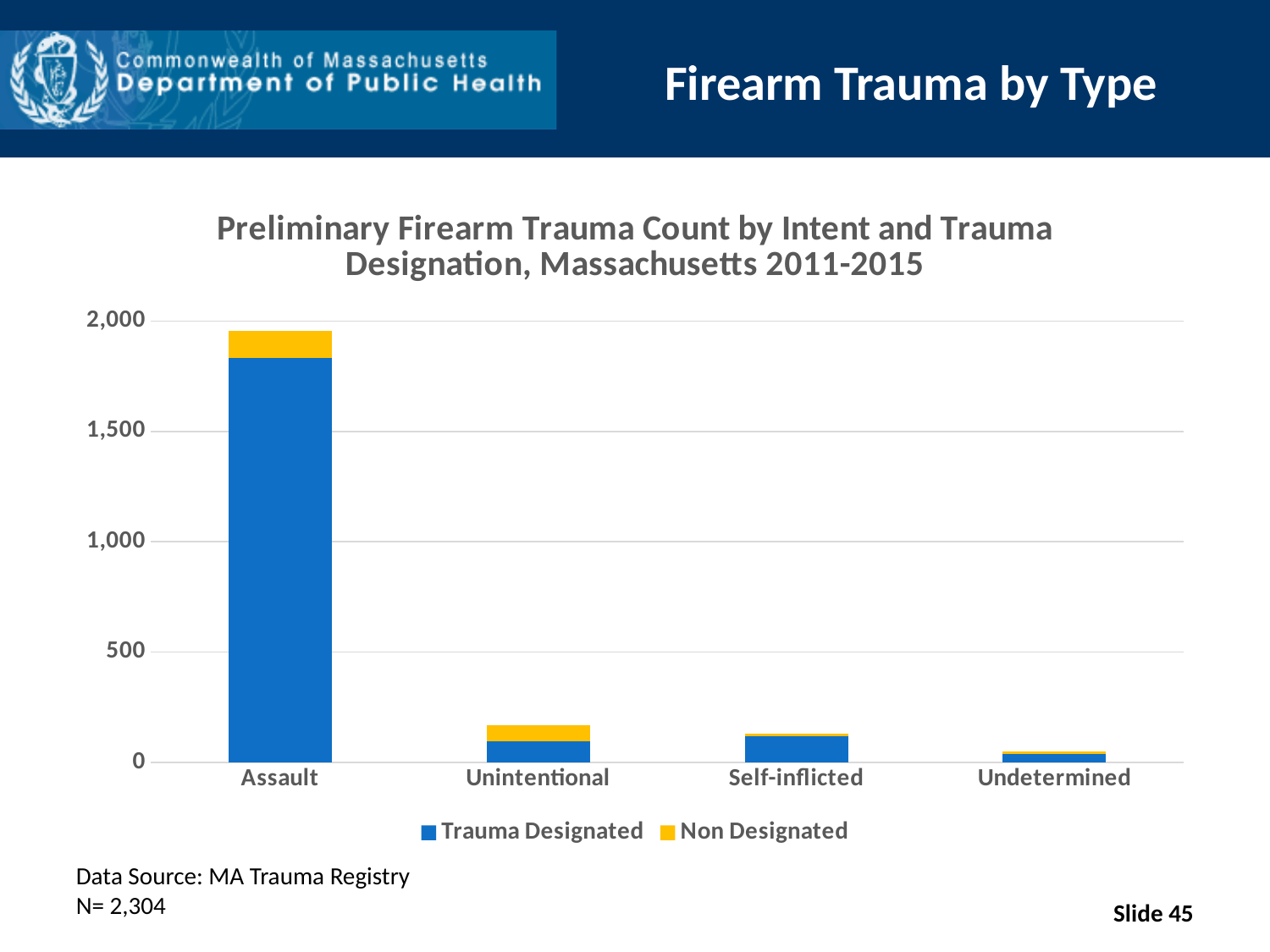
Is the total value for Assault greater or less than 1,500? greater Is the total value for Unintentional greater or less than 500? less Which series is shown in yellow in the legend? Non Designated Is the total value for Self-inflicted greater or less than 500? less Which has a larger total count, Assault or Unintentional? Assault Which intent category has the lowest total firearm trauma count? Undetermined How many series does the legend list? 2 Which has a larger total count, Unintentional or Undetermined? Unintentional What kind of chart is shown on the slide? Stacked bar chart Which intent category has the highest total firearm trauma count? Assault How many intent categories are shown on the x axis? 4